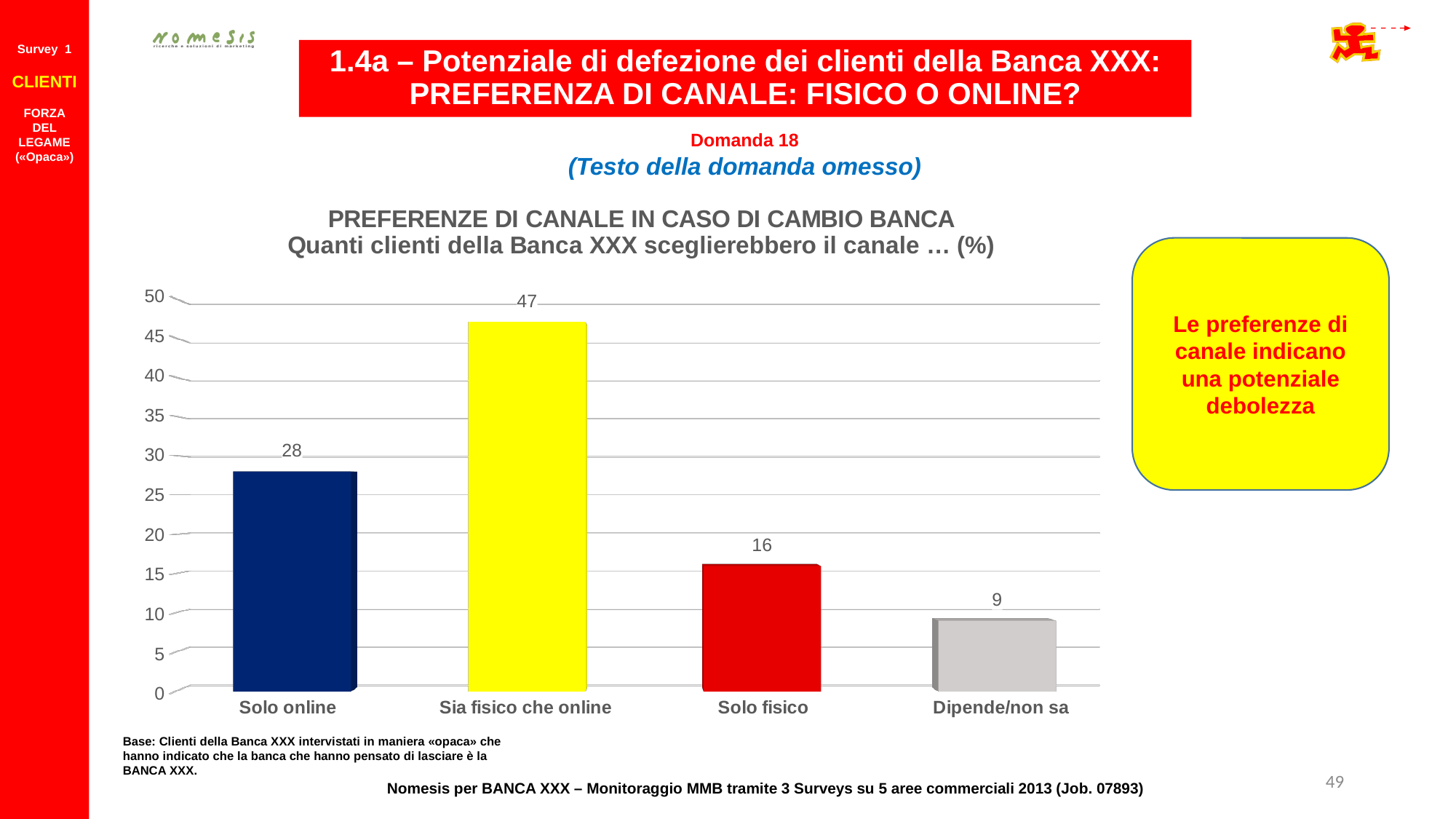
Which category has the lowest value? Dipende/non sa What is the difference between the values for "Sia fisico che online" and "Solo online"? 19 What kind of chart is shown on the slide? Bar chart What is the value for "Solo fisico"? 16 What is the value for "Solo online"? 28 How many categories are shown on the x axis of the chart? 4 What is the value for "Sia fisico che online"? 47 What is the difference between the values for "Solo fisico" and "Dipende/non sa"? 7 Which category has the highest value? Sia fisico che online Which is larger, the value for "Solo online" or the value for "Solo fisico"? Solo online What is the value for "Dipende/non sa"? 9 What colour is the bar for "Sia fisico che online"? Yellow